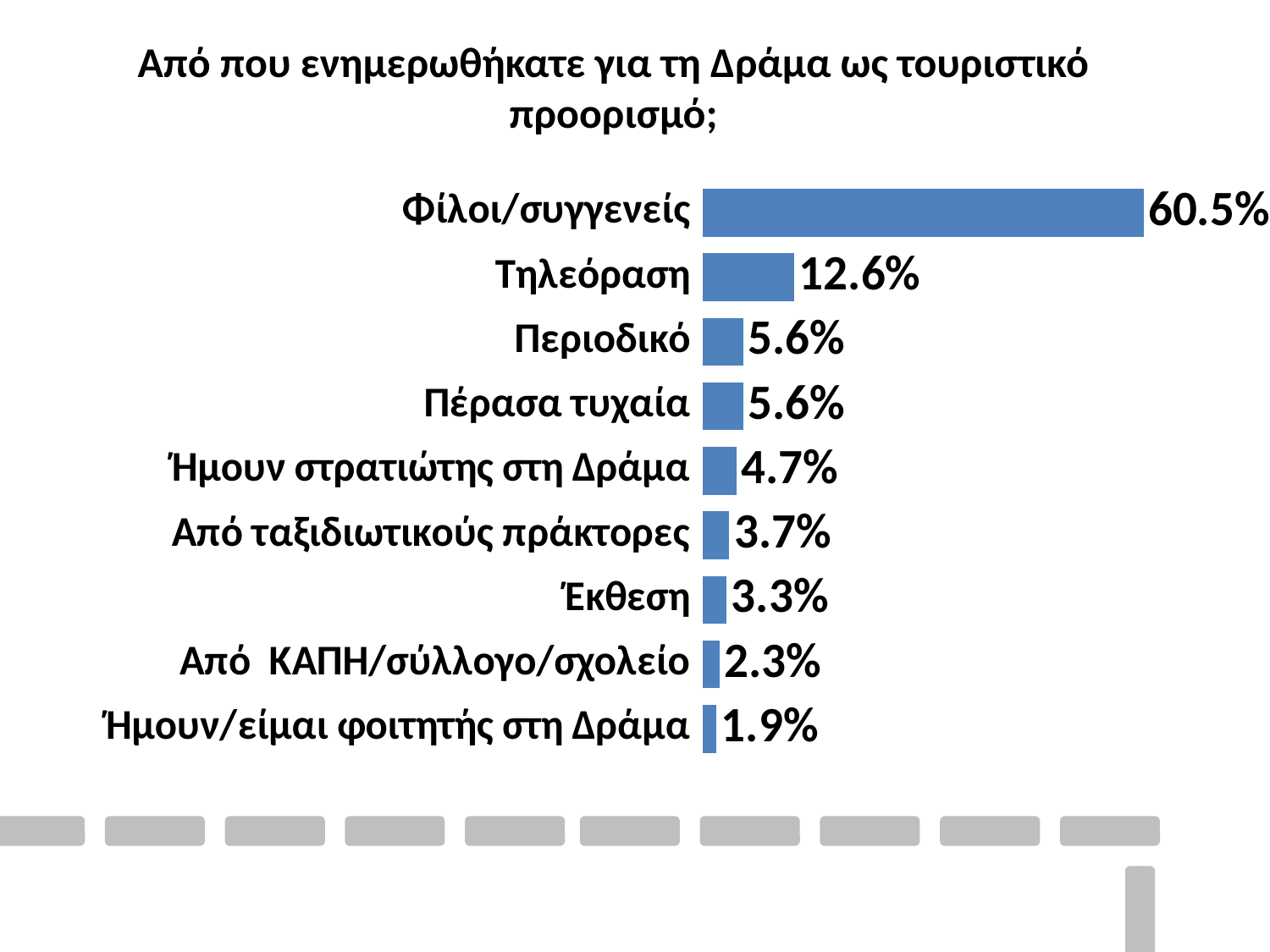
Which is larger, the value for Τηλεόραση or the value for Περιοδικό? Τηλεόραση Which category has the lowest value? Ήμουν/είμαι φοιτητής στη Δράμα What is the difference between the values for Από ταξιδιωτικούς πράκτορες and Έκθεση? 0.4% What is the value for Ήμουν στρατιώτης στη Δράμα? 4.7% What is the value for Φίλοι/συγγενείς? 60.5% What is the value for Από ΚΑΠΗ/σύλλογο/σχολείο? 2.3% What is the value for Τηλεόραση? 12.6% How many categories are shown in the chart? 9 What is the difference between the values for Φίλοι/συγγενείς and Τηλεόραση? 47.9% What is the title of the chart? Από που ενημερωθήκατε για τη Δράμα ως τουριστικό προορισμό; Which category has the highest value? Φίλοι/συγγενείς What kind of chart is shown on the slide? bar chart